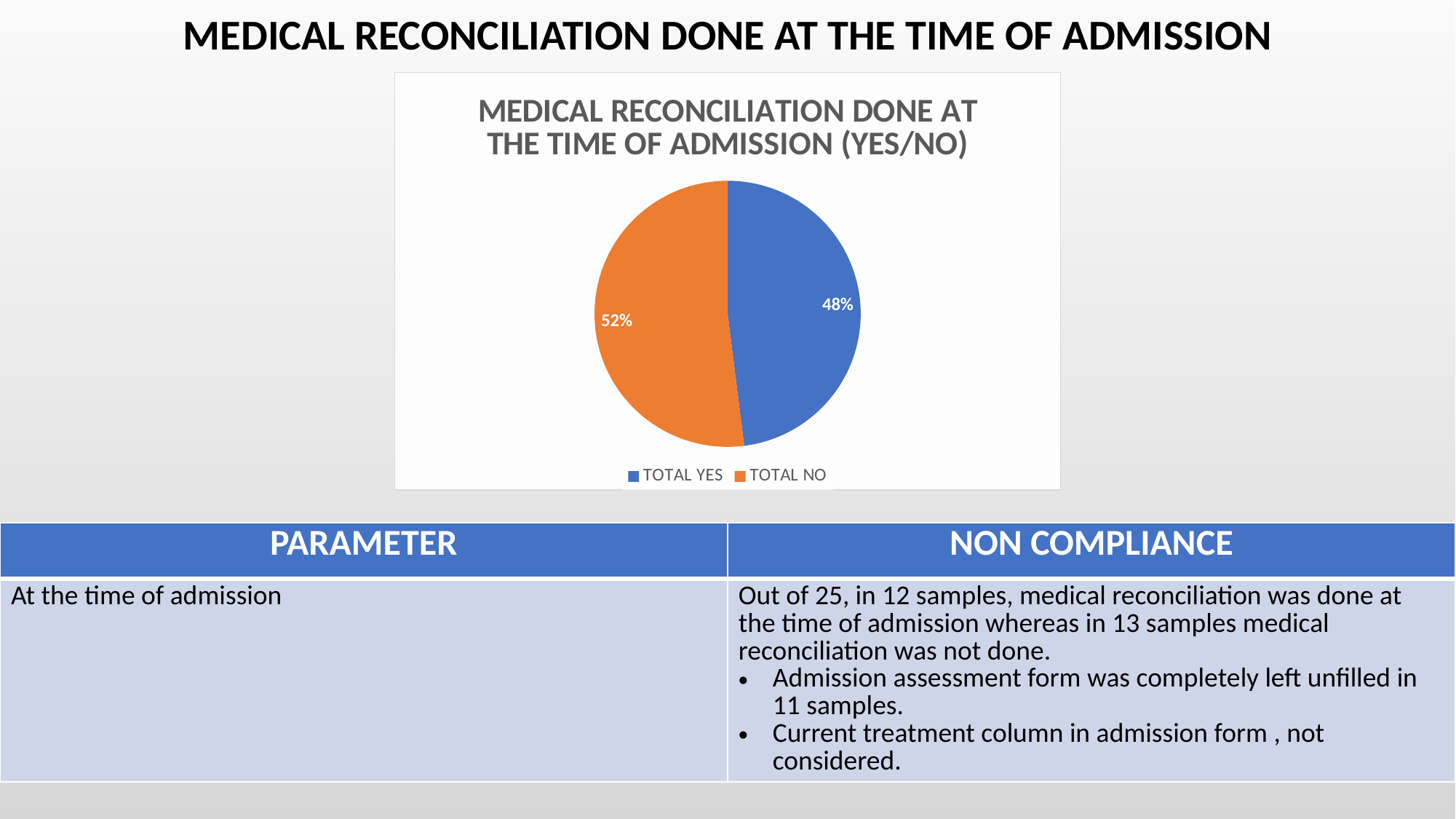
How many entries does the legend list? 2 What is the title of the chart? MEDICAL RECONCILIATION DONE AT THE TIME OF ADMISSION (YES/NO) What percentage of the pie is TOTAL NO? 52% What colour is the TOTAL NO slice? Orange What is the difference in percentage points between TOTAL NO and TOTAL YES? 4 What share of the pie does TOTAL YES represent? 48% Which slice is the largest in the pie chart? TOTAL NO What type of chart is shown on the slide? Pie chart Which is larger, TOTAL YES or TOTAL NO? TOTAL NO What percentage of the pie is TOTAL YES? 48% How many slices does the pie chart have? 2 Which slice is the smallest in the pie chart? TOTAL YES